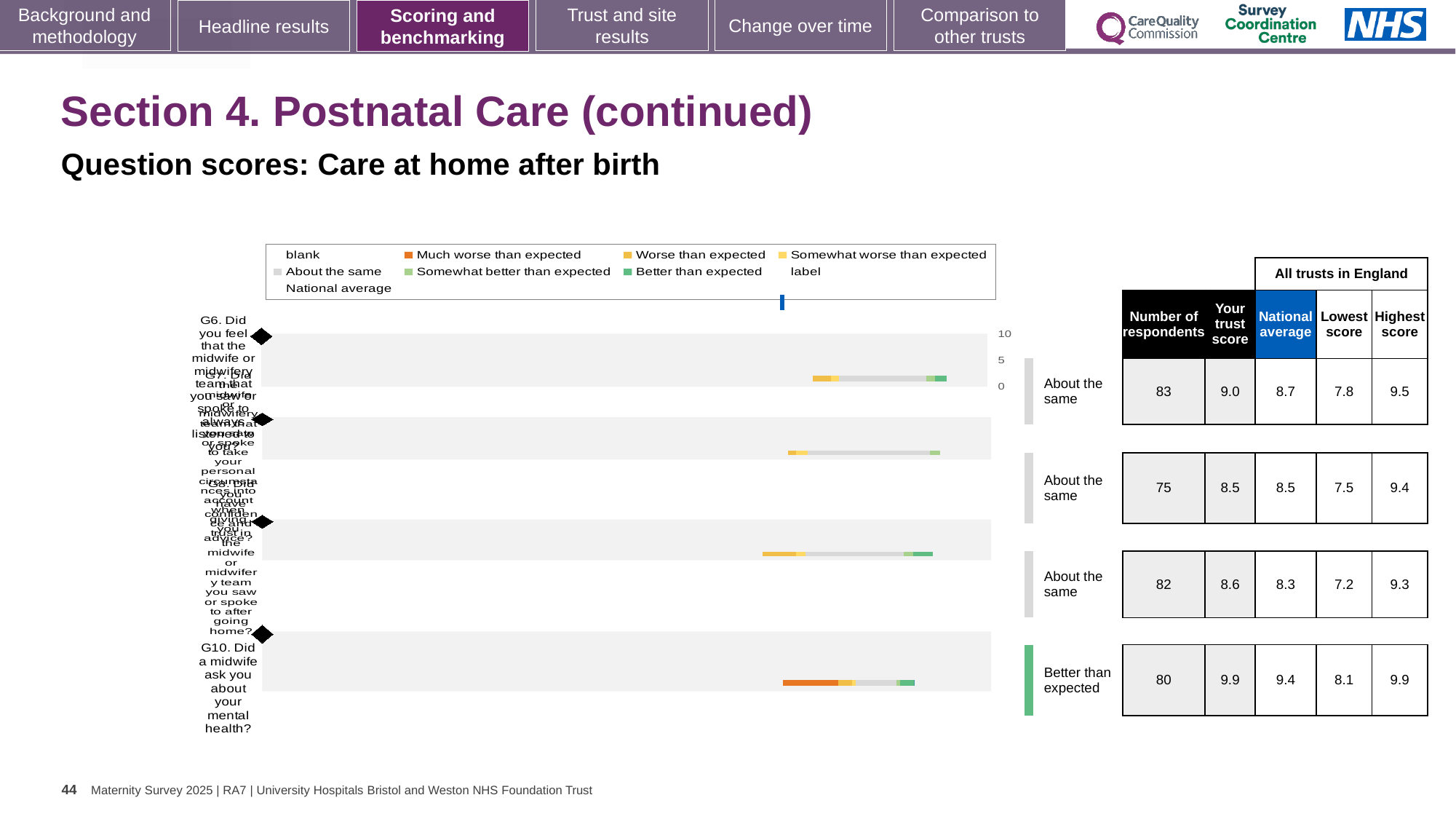
How many question bars are plotted in the chart? 4 What is the difference between the trust score and the national average for G10? 0.5 What is the highest score across all trusts in England for the top question (G6)? 9.5 How many respondents answered G10 (Did a midwife ask you about your mental health?)? 80 How many of the questions are rated 'About the same'? 3 What is the national average for G10 (Did a midwife ask you about your mental health?)? 9.4 Which question has the highest 'Your trust score'? G10 (9.9) For the top question (G6), which is larger: the trust score or the national average? Your trust score (9.0) What benchmark category is shown for G10 (Did a midwife ask you about your mental health?)? Better than expected What is the 'Your trust score' for G10 (Did a midwife ask you about your mental health?)? 9.9 What kind of chart is shown on the slide? bar chart What is the lowest score across all trusts in England for G10? 8.1